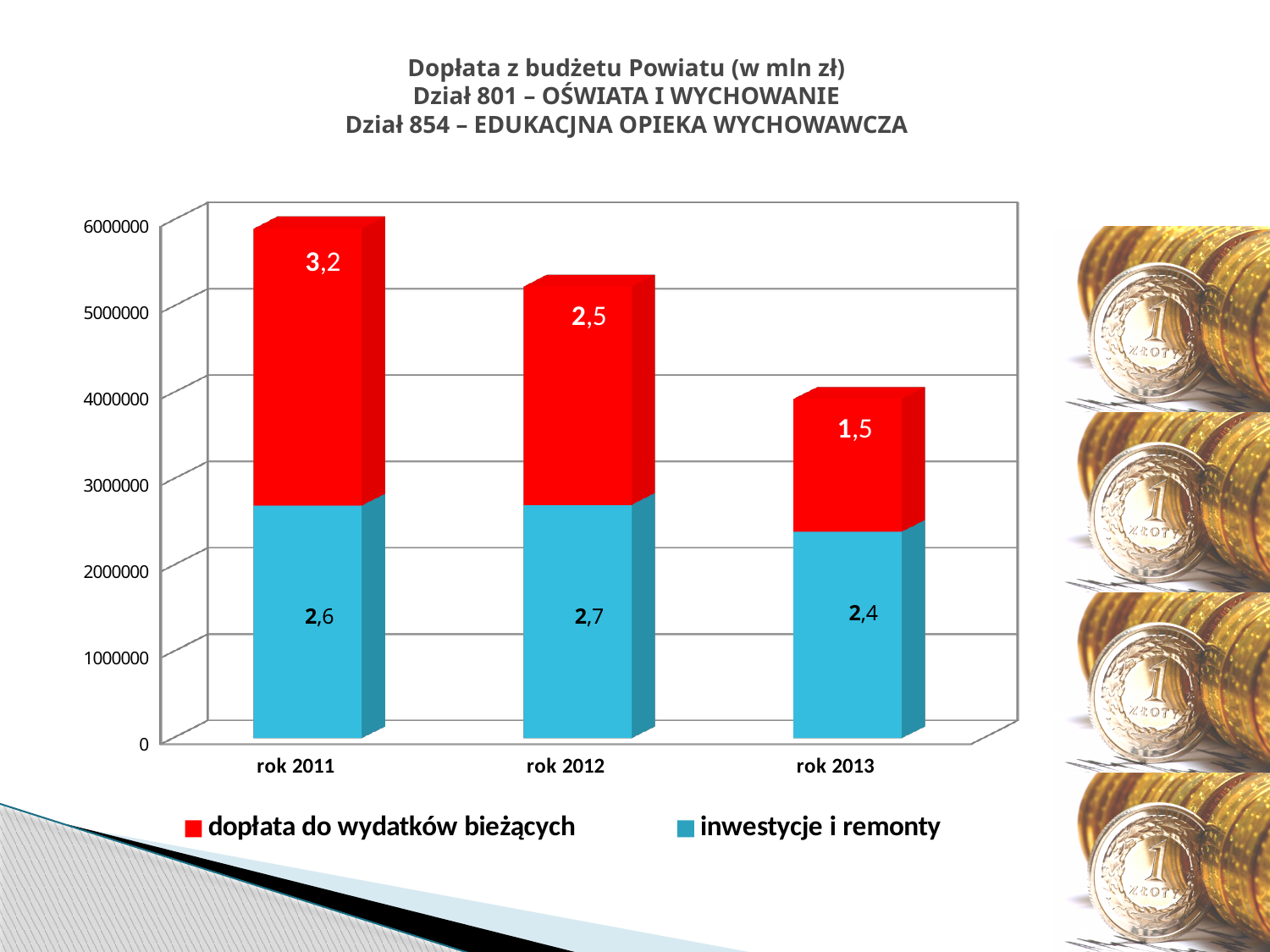
How many years are shown on the x axis? 3 In which year is 'dopłata do wydatków bieżących' the highest? rok 2011 What is the value of 'inwestycje i remonty' for rok 2012? 2,7 What is the value of 'inwestycje i remonty' for rok 2013? 2,4 What is the value of 'dopłata do wydatków bieżących' for rok 2011? 3,2 What is the value of 'dopłata do wydatków bieżących' for rok 2013? 1,5 How many series does the legend list? 2 What is the total of the stacked bar for rok 2011? 5,8 Which is larger in rok 2012: 'dopłata do wydatków bieżących' or 'inwestycje i remonty'? inwestycje i remonty In which year is 'inwestycje i remonty' the lowest? rok 2013 What kind of chart is shown on the slide? stacked bar chart What is the difference between 'dopłata do wydatków bieżących' in rok 2011 and rok 2013? 1,7